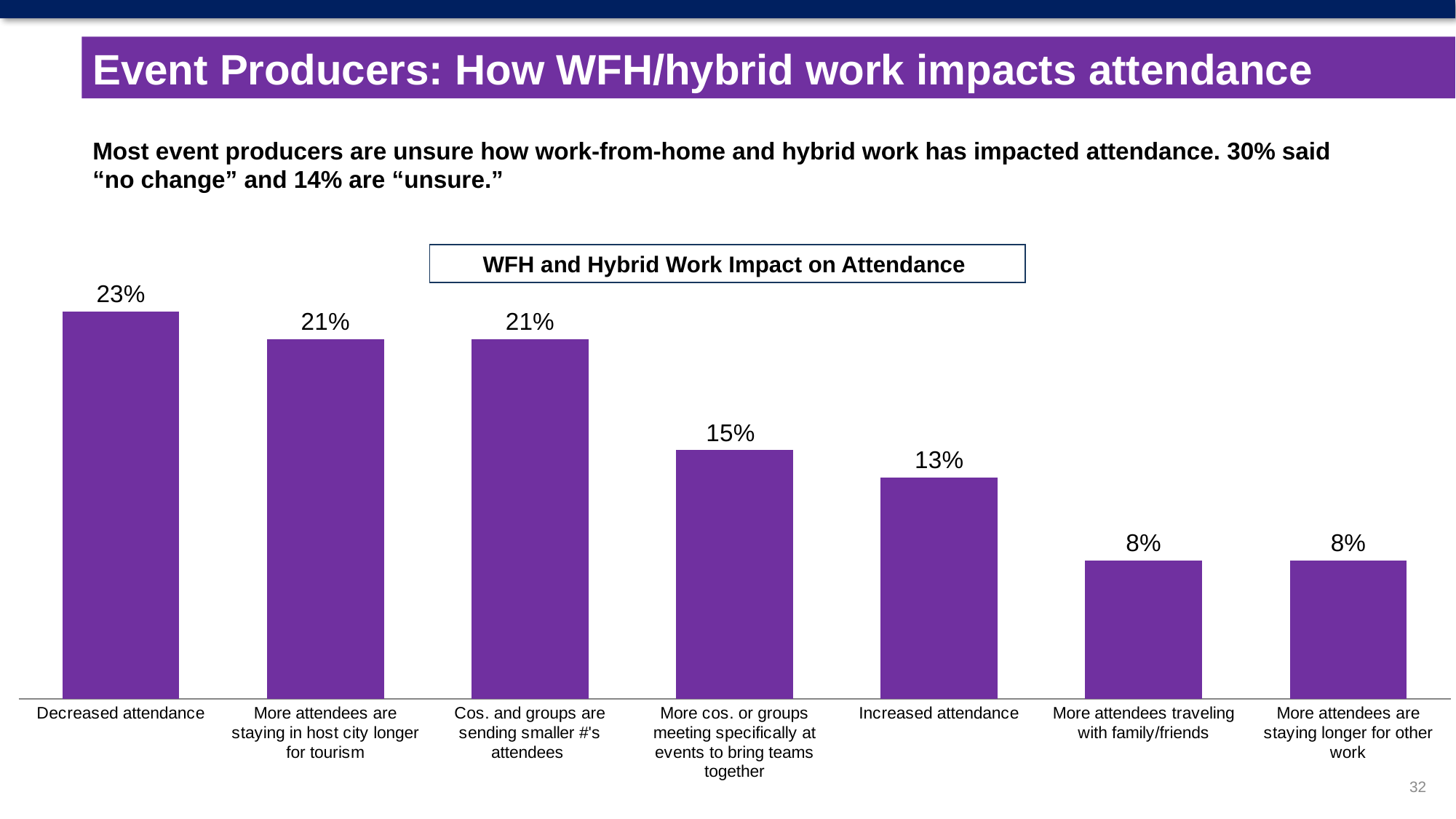
How many categories are shown in the chart? 7 Which category has the highest value? Decreased attendance What is the difference between "Decreased attendance" and "Increased attendance"? 10% What is the difference between "More attendees are staying in host city longer for tourism" and "More attendees are staying longer for other work"? 13% Which is larger: "Cos. and groups are sending smaller #'s attendees" or "More cos. or groups meeting specifically at events to bring teams together"? Cos. and groups are sending smaller #'s attendees What is the value for "More attendees traveling with family/friends"? 8% What is the value for "Increased attendance"? 13% What kind of chart is shown on the slide? Bar chart What is the value for "More cos. or groups meeting specifically at events to bring teams together"? 15% What is the value for "Decreased attendance"? 23% Do the values rise or fall from left to right across the chart? Fall What is the title of the chart? WFH and Hybrid Work Impact on Attendance